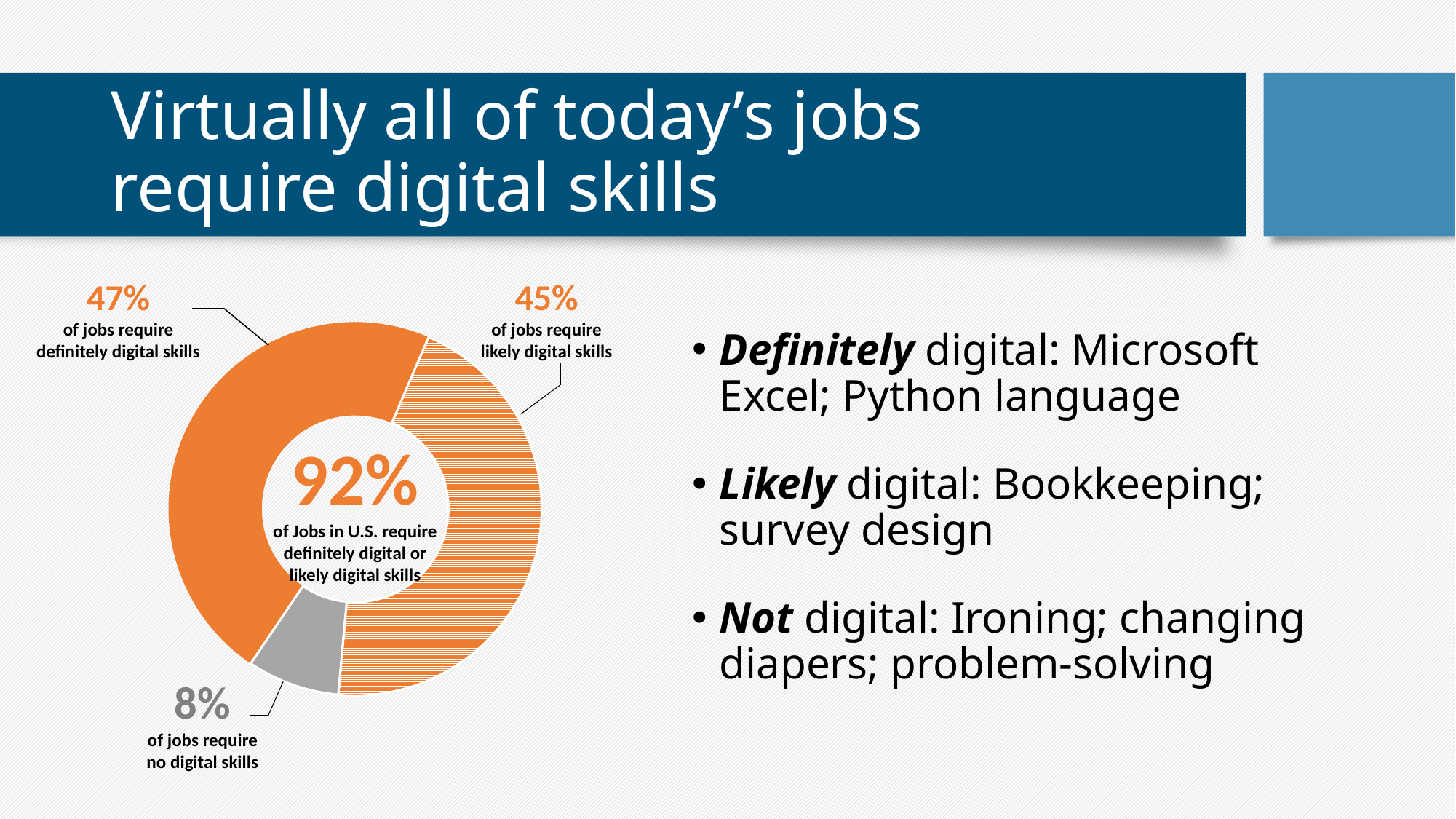
How many categories does the doughnut chart show? 3 What percentage of jobs require likely digital skills? 45% Which is larger: the share of jobs requiring likely digital skills or the share requiring no digital skills? Likely digital skills What kind of chart is shown on the slide? Doughnut chart Which category has the largest share of the chart? Jobs that require definitely digital skills What percentage is shown in the centre of the doughnut chart? 92% What is the difference between the share of jobs requiring definitely digital skills and the share requiring no digital skills? 39 percentage points Which category has the smallest share of the chart? Jobs that require no digital skills What colour is the segment for jobs that require no digital skills? Grey What percentage of jobs require no digital skills? 8% What percentage of jobs require definitely digital skills? 47% What is the combined share of jobs requiring definitely digital or likely digital skills? 92%